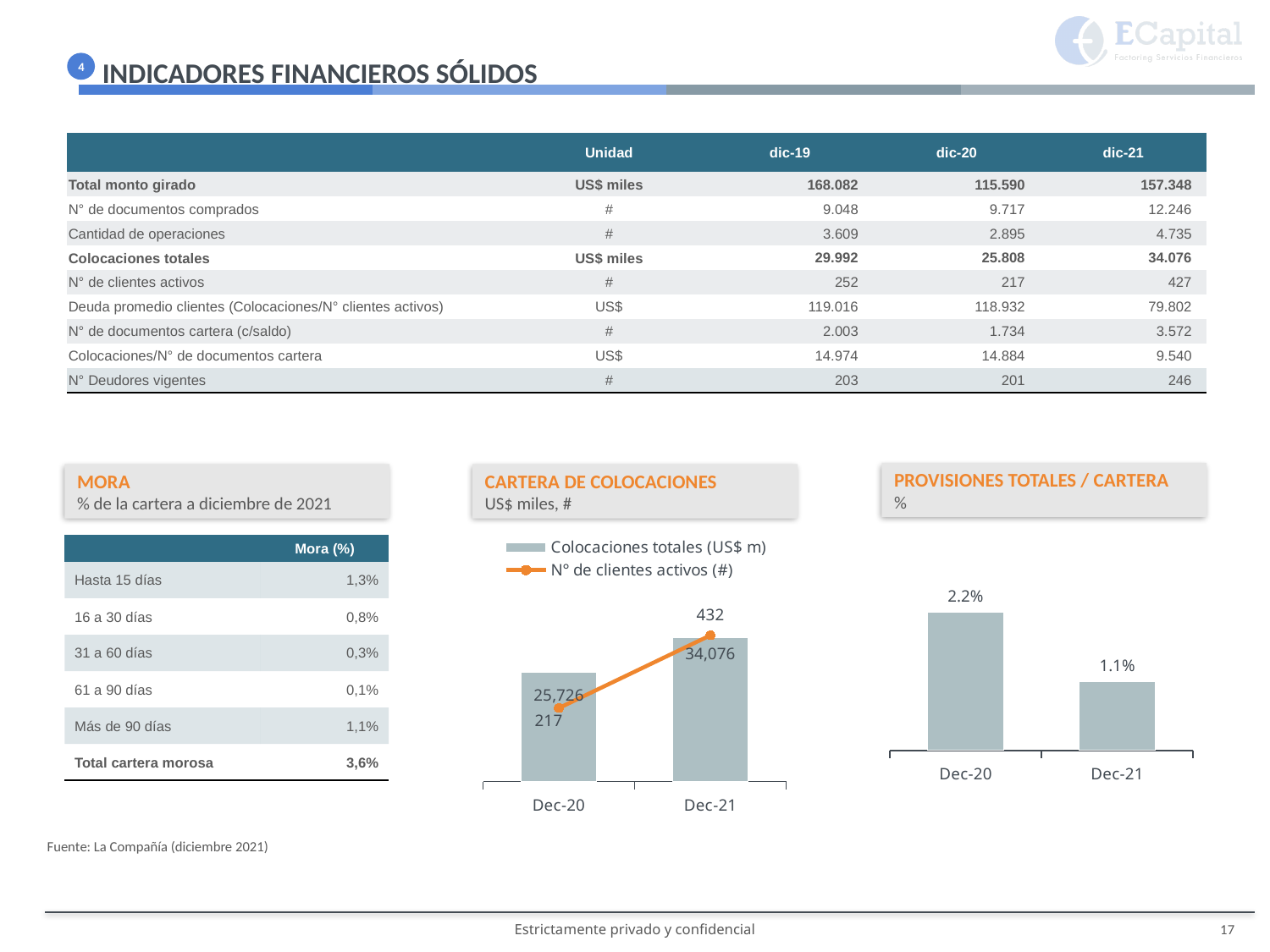
In the PROVISIONES TOTALES / CARTERA chart, what is the difference between the Dec-20 and Dec-21 values? 1.1% In the CARTERA DE COLOCACIONES chart, how many N° de clientes activos are shown for Dec-20? 217 In the PROVISIONES TOTALES / CARTERA chart, which period has the higher value? Dec-20 In the CARTERA DE COLOCACIONES chart, what is the value of Colocaciones totales for Dec-21? 34,076 In the CARTERA DE COLOCACIONES chart, what is the value of Colocaciones totales for Dec-20? 25,726 In the CARTERA DE COLOCACIONES chart, by how much did N° de clientes activos increase from Dec-20 to Dec-21? 215 In the CARTERA DE COLOCACIONES chart, how many series does the legend list? 2 In the PROVISIONES TOTALES / CARTERA chart, what is the value for Dec-20? 2.2% In the CARTERA DE COLOCACIONES chart, how many N° de clientes activos are shown for Dec-21? 432 In the PROVISIONES TOTALES / CARTERA chart, what is the value for Dec-21? 1.1% In the CARTERA DE COLOCACIONES chart, do Colocaciones totales rise or fall from Dec-20 to Dec-21? rise What kind of chart is the PROVISIONES TOTALES / CARTERA chart? bar chart